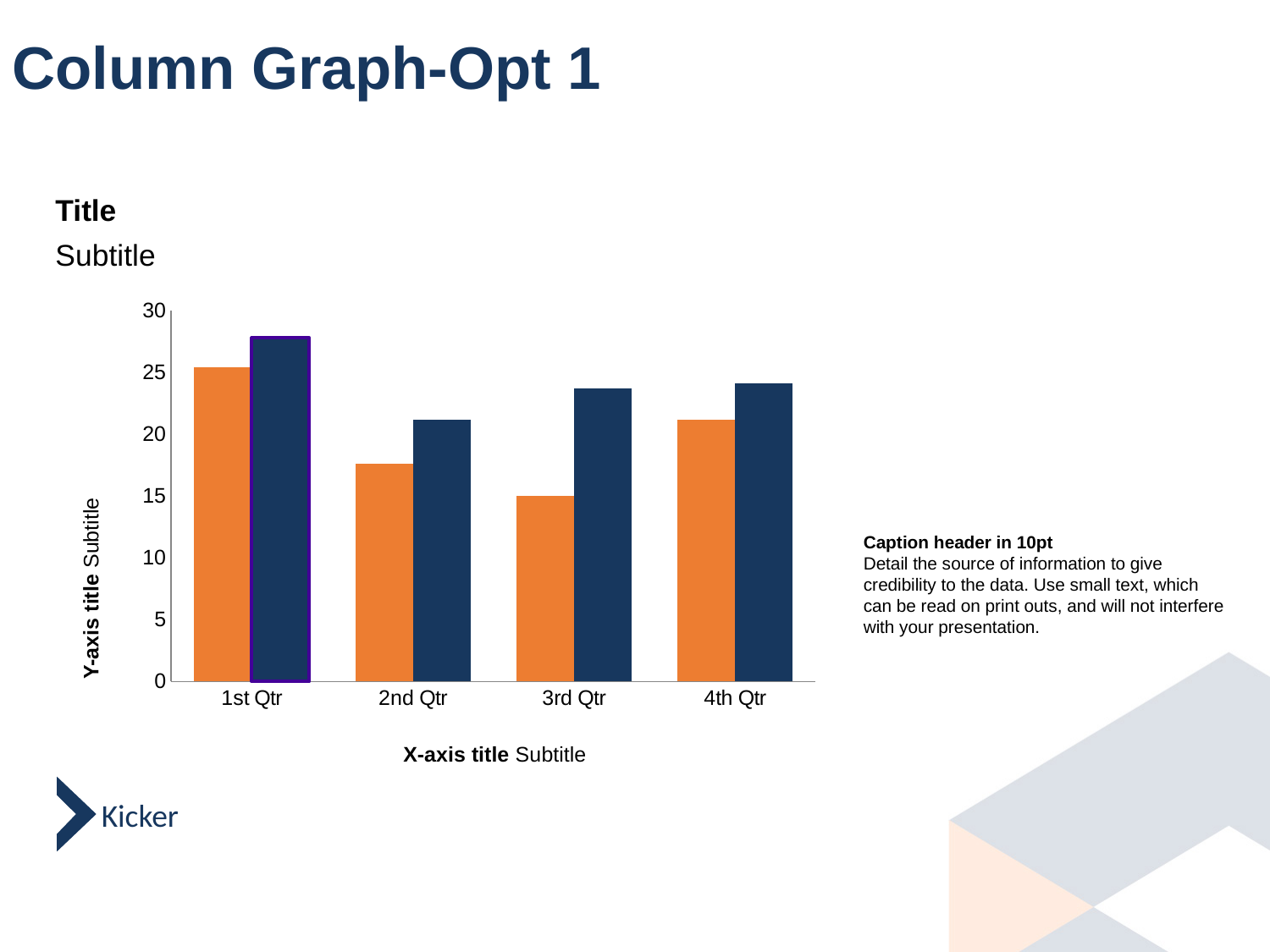
Which category has the shortest orange bar? 3rd Qtr Do the orange bars rise or fall from 1st Qtr to 3rd Qtr? fall Is the value of the dark blue bar for 1st Qtr greater or less than 25? greater How many bars are plotted in total across all categories? 8 Is the value of the orange bar for 3rd Qtr greater or less than 20? less What is the x-axis title of the chart? X-axis title Subtitle Which category has the shortest dark blue bar? 2nd Qtr How many categories are shown on the x axis? 4 Which category has the tallest dark blue bar? 1st Qtr Which category has the tallest orange bar? 1st Qtr In 3rd Qtr, which bar is taller, the orange bar or the dark blue bar? dark blue What kind of chart is shown on the slide? bar chart